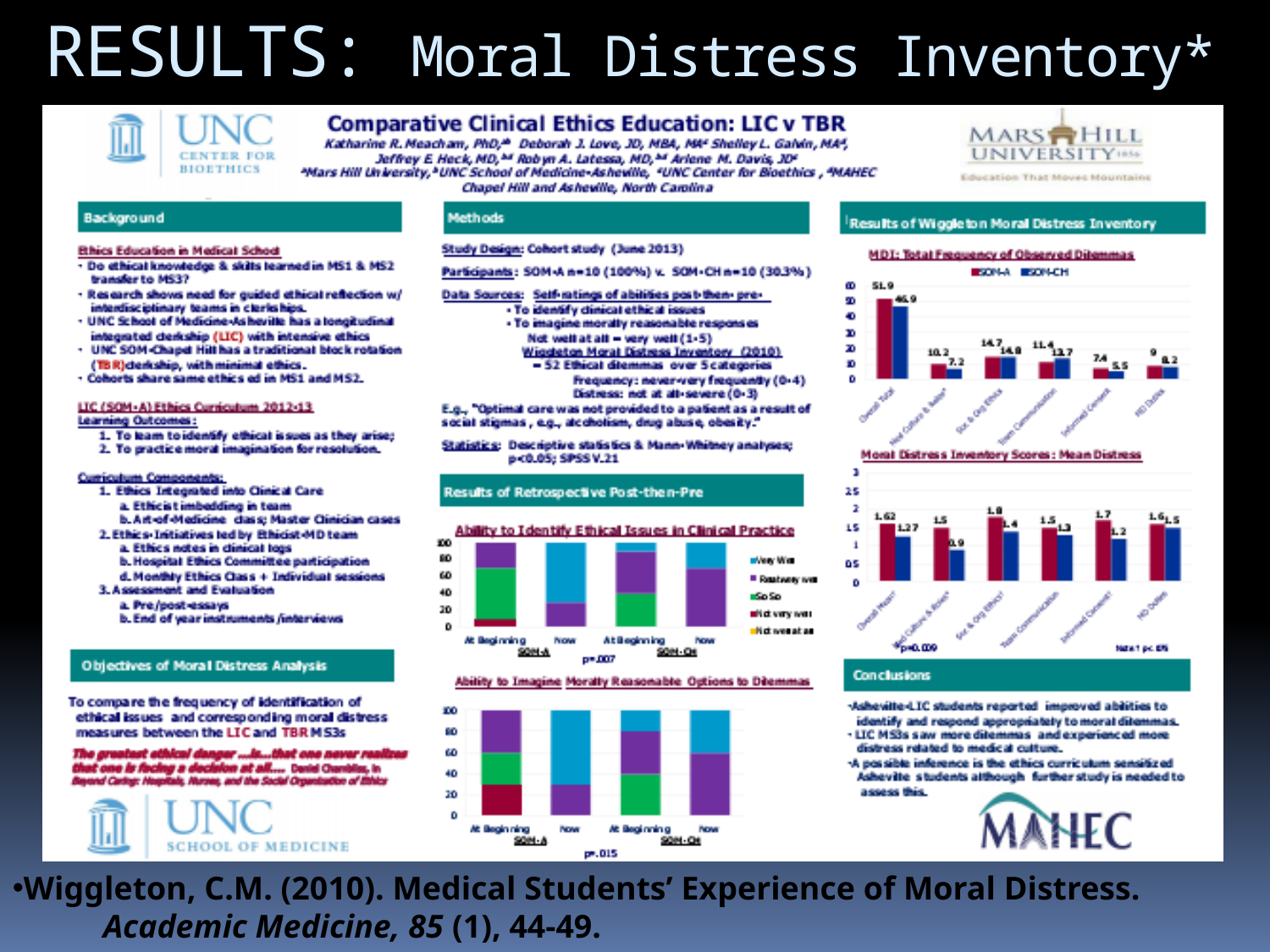
In the chart titled 'Moral Distress Inventory Scores: Mean Distress', what is the lowest SOM-CH value shown? 0.9 In the chart titled 'MDI: Total Frequency of Observed Dilemmas', how many categories are shown on the x axis? 6 In the chart titled 'MDI: Total Frequency of Observed Dilemmas', what is the SOM-A value for Overall Total? 51.9 In the chart titled 'Ability to Identify Ethical Issues in Clinical Practice', how many entries does the legend list? 5 In the chart titled 'MDI: Total Frequency of Observed Dilemmas', what kind of chart is shown? Bar chart In the chart titled 'Moral Distress Inventory Scores: Mean Distress', what is the SOM-A value for the first category (Overall Mean)? 1.62 In the chart titled 'MDI: Total Frequency of Observed Dilemmas', what is the SOM-CH value for Overall Total? 46.9 In the chart titled 'Ability to Imagine Morally Reasonable Options to Dilemmas', how many stacked bars are shown? 4 In the chart titled 'Moral Distress Inventory Scores: Mean Distress', what is the highest SOM-A value shown? 1.8 In the chart titled 'MDI: Total Frequency of Observed Dilemmas', what is the difference between the SOM-A and SOM-CH values for Overall Total? 5 In the chart titled 'MDI: Total Frequency of Observed Dilemmas', which series has the larger Overall Total value, SOM-A or SOM-CH? SOM-A In the chart titled 'MDI: Total Frequency of Observed Dilemmas', how many series does the legend list? 2